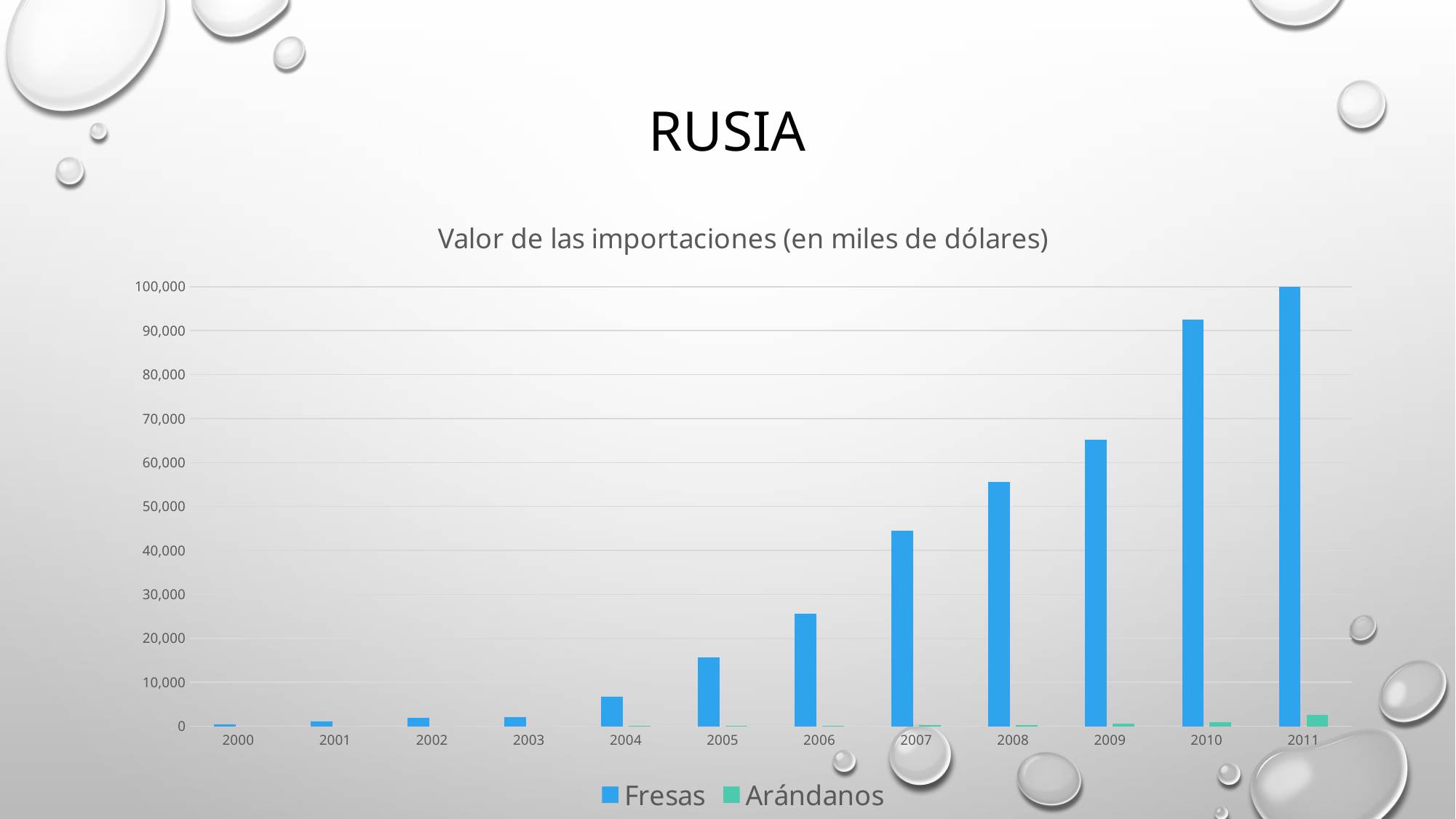
Do the values for Fresas rise or fall from 2000 to 2011? rise How many years are shown on the x axis? 12 In which year is the value for Fresas lowest? 2000 In which year is the value for Fresas highest? 2011 Is the value for Fresas in 2006 greater or less than 20,000? greater Is the value for Arándanos in 2011 greater or less than 10,000? less Is the value for Fresas in 2010 greater or less than 80,000? greater Which series has the larger value in 2011, Fresas or Arándanos? Fresas What kind of chart is shown on the slide? bar chart What is the title of the chart? Valor de las importaciones (en miles de dólares) How many series does the legend list? 2